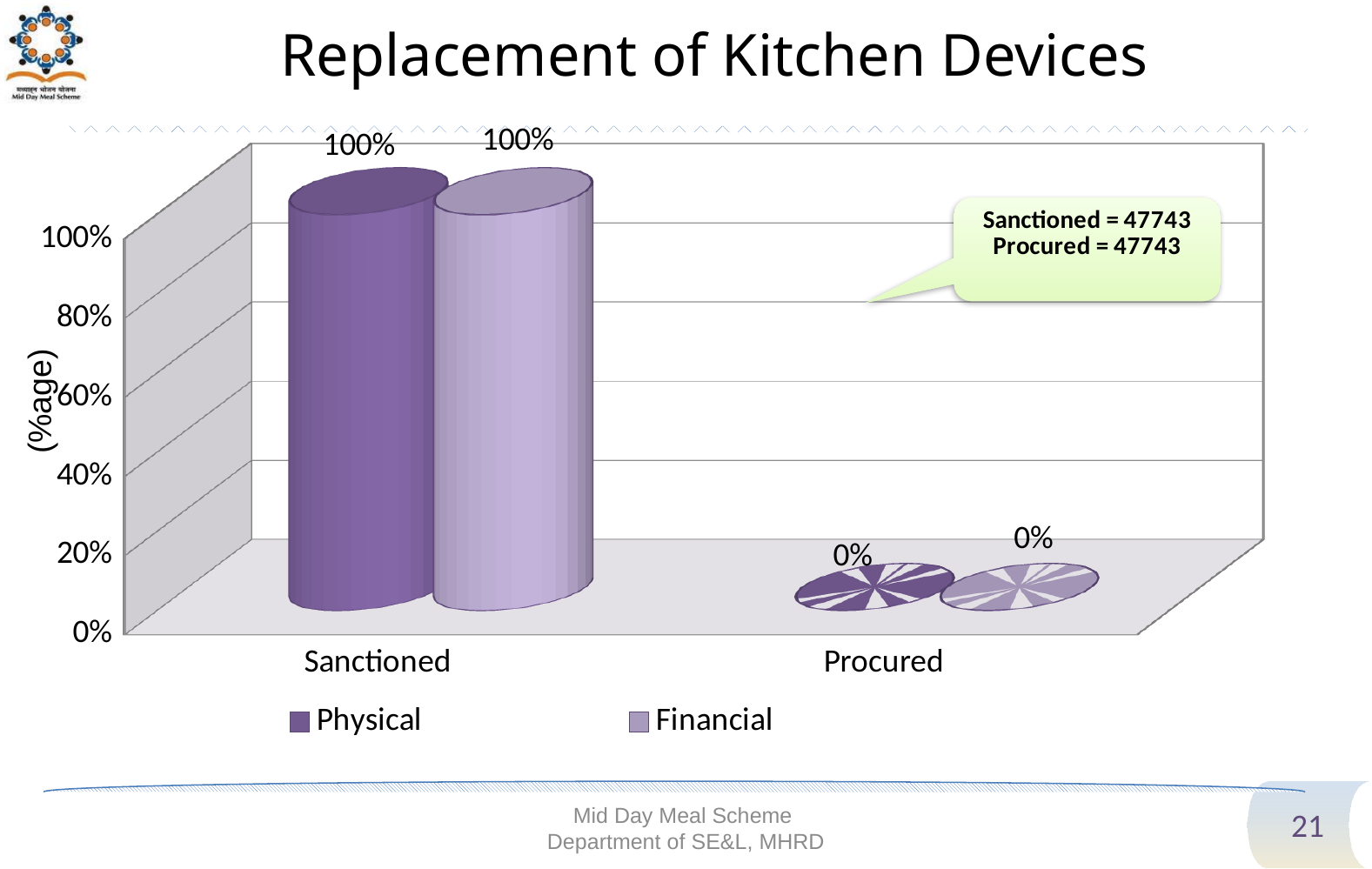
Which category has the highest Physical value? Sanctioned What kind of chart is shown on the slide? Bar chart What is the Physical value for Sanctioned? 100% What is the title of the chart? Replacement of Kitchen Devices Which is larger, the Financial value for Sanctioned or the Financial value for Procured? Sanctioned Which category has the lowest Financial value? Procured What is the difference between the Physical value for Sanctioned and the Physical value for Procured? 100% What is the Physical value for Procured? 0% What is the Financial value for Sanctioned? 100% What is the Financial value for Procured? 0% How many series does the legend list? 2 How many categories are shown on the x axis? 2